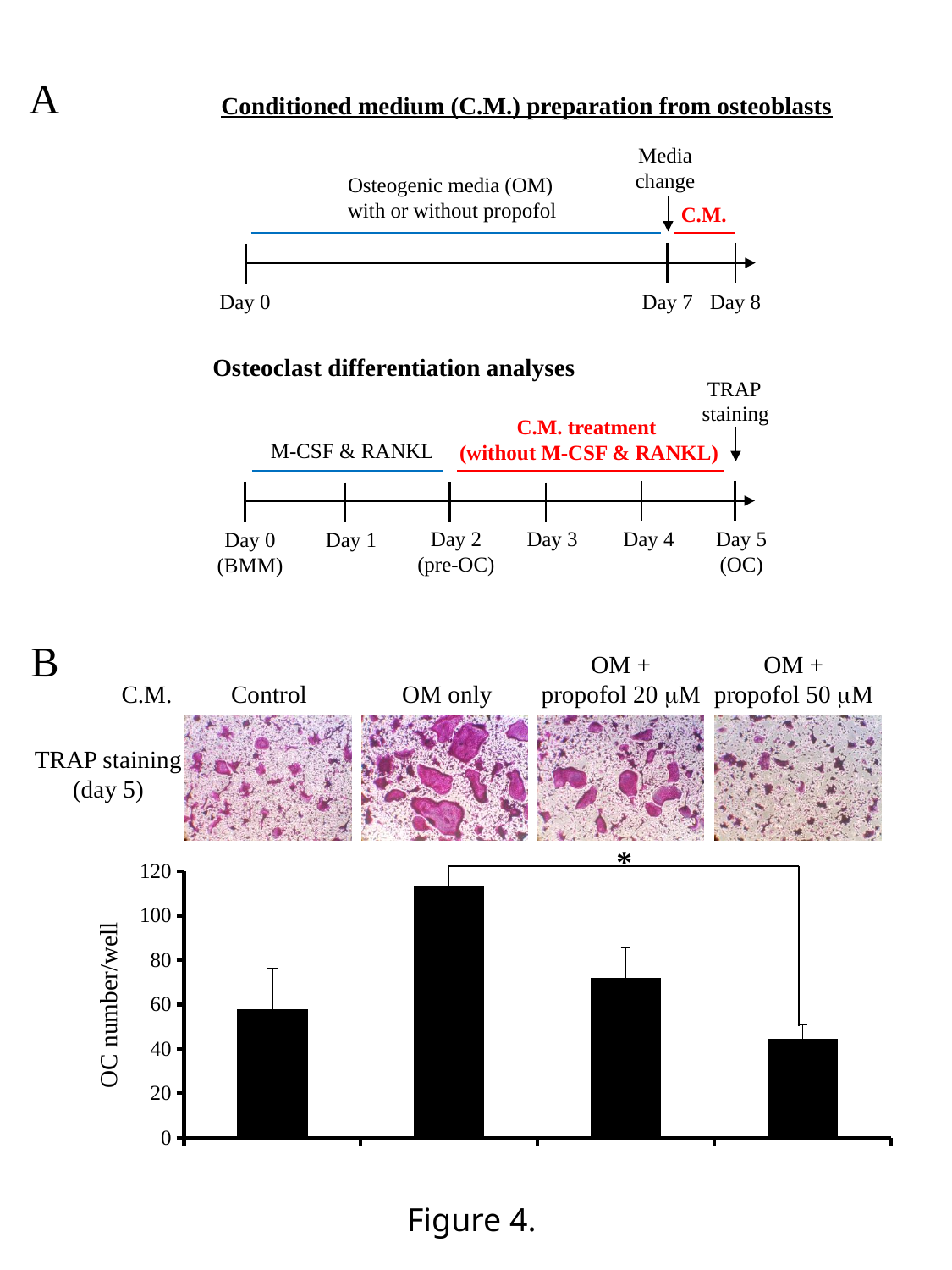
In the bar chart in panel B, is the OC number/well for Control greater or less than 40? greater In the bar chart in panel B, is the OC number/well for OM only greater or less than 100? greater In the bar chart in panel B, which has a higher OC number/well: Control or OM + propofol 50 μM? Control How many bars (categories) are plotted in the bar chart in panel B? 4 In the bar chart in panel B, which condition has the lowest OC number/well? OM + propofol 50 μM What is the maximum value shown on the y axis of the bar chart in panel B? 120 In the bar chart in panel B, which condition has the highest OC number/well? OM only In the bar chart in panel B, is the OC number/well for OM + propofol 50 μM greater or less than 60? less What is the label of the y axis of the bar chart in panel B? OC number/well What kind of chart is shown in panel B? bar chart In the bar chart in panel B, which has a higher OC number/well: Control or OM + propofol 20 μM? OM + propofol 20 μM